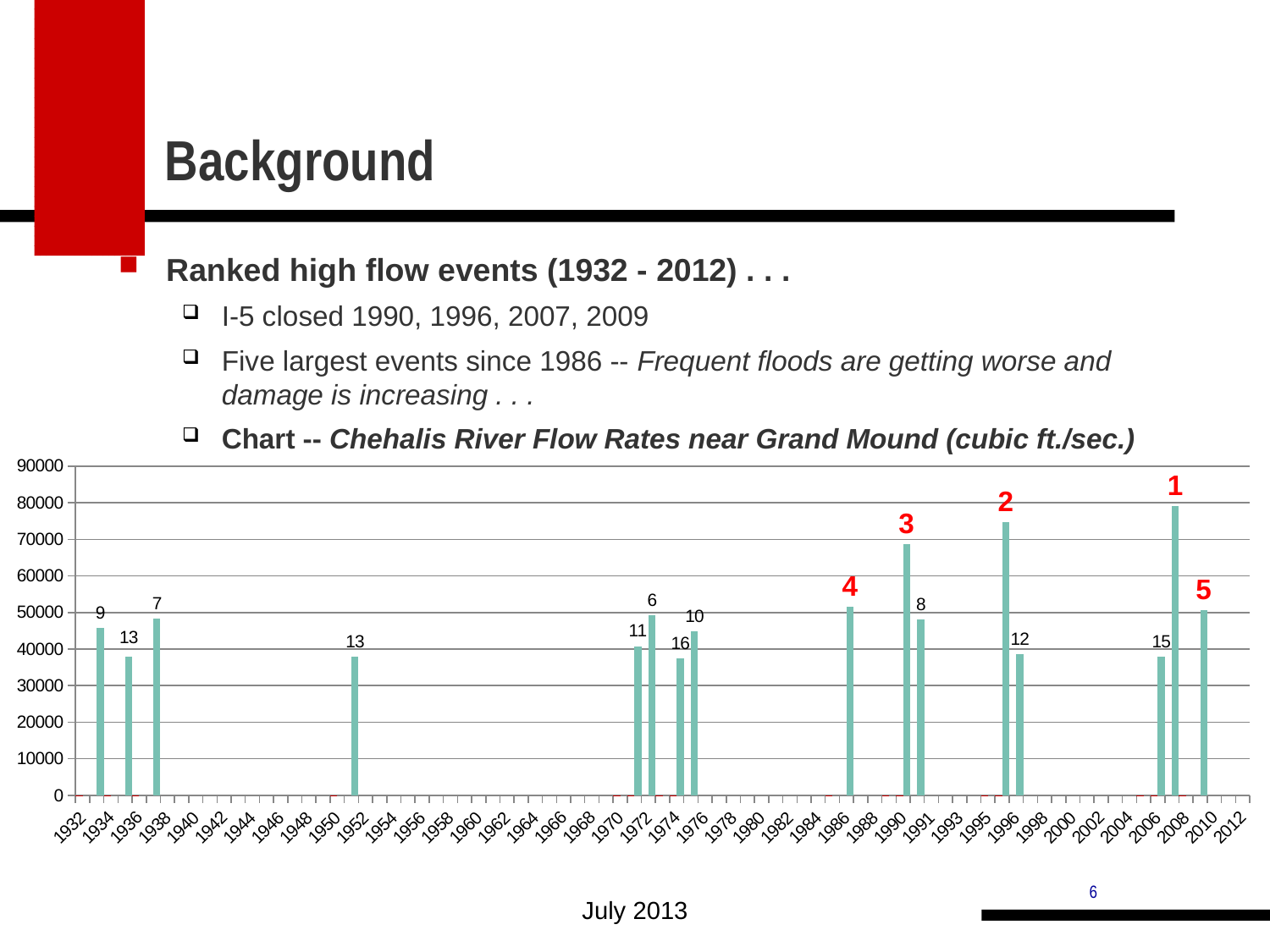
Which bar is taller, the one labelled 1 or the one labelled 5? the one labelled 1 Is the value of the bar labelled 7 greater or less than 50000? less Is the value of the bar labelled 3 greater or less than 70000? less Which bar is taller, the one labelled 2 or the one labelled 3? the one labelled 2 What is the title of the chart on the slide? Chehalis River Flow Rates near Grand Mound (cubic ft./sec.) Is the value of the bar labelled 2 greater or less than 70000? greater Which rank label is shown above the tallest bar in the chart? 1 How many bars are plotted in the chart? 16 What is the highest value shown on the chart's vertical axis? 90000 What kind of chart is shown on the slide? bar chart